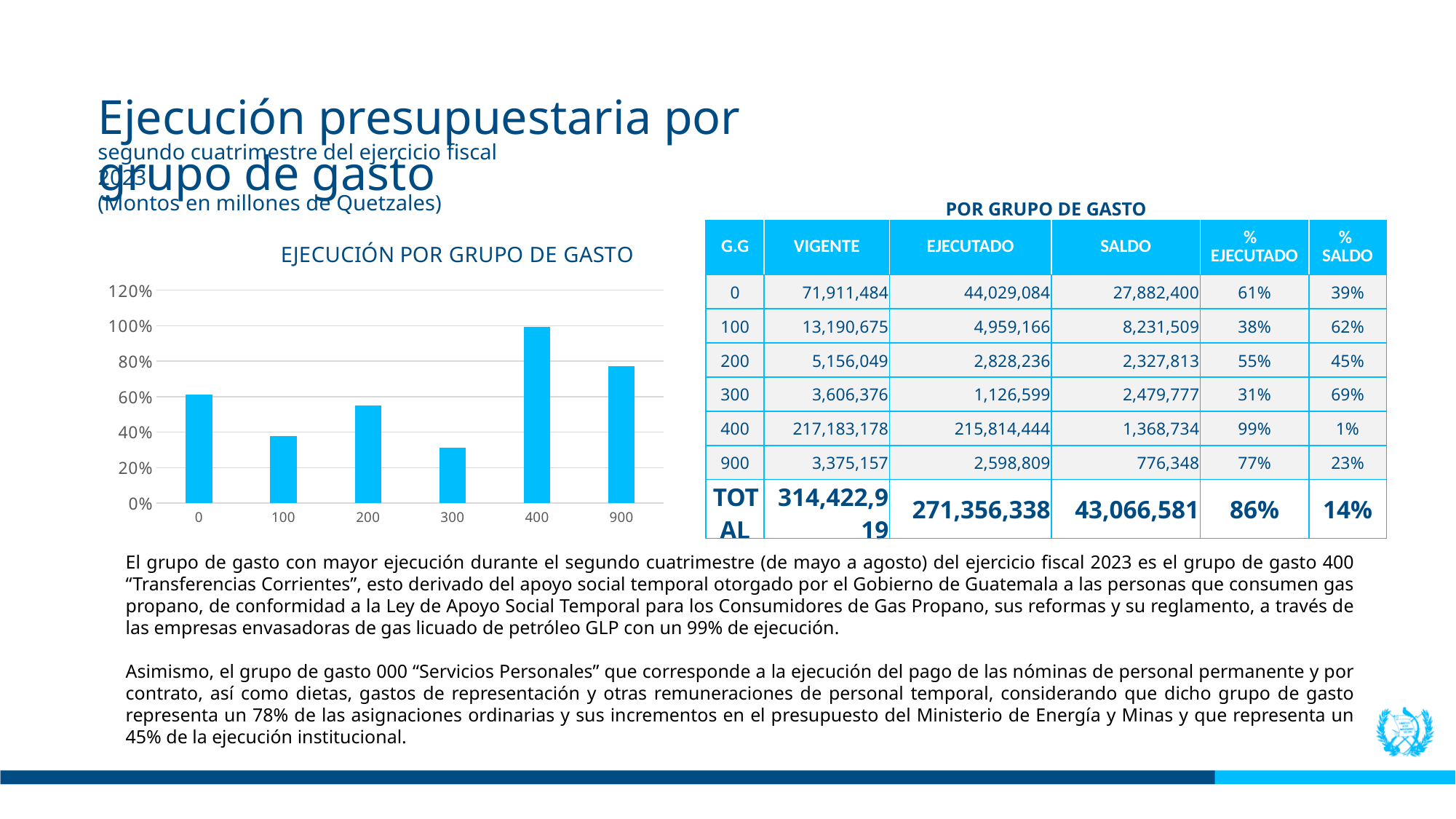
Which grupo de gasto has the lowest bar in the chart? 300 What type of chart is shown on the slide? bar chart Is the value for grupo de gasto 400 greater or less than 80%? greater What is the title of the chart? EJECUCIÓN POR GRUPO DE GASTO Is the value for grupo de gasto 300 greater or less than 40%? less Which grupo de gasto has the highest bar in the chart? 400 Is the value for grupo de gasto 100 greater or less than 60%? less How many categories (grupos de gasto) are shown on the x axis of the chart? 6 Which has the larger bar in the chart, grupo de gasto 200 or grupo de gasto 900? 900 Which has the larger bar in the chart, grupo de gasto 0 or grupo de gasto 100? 0